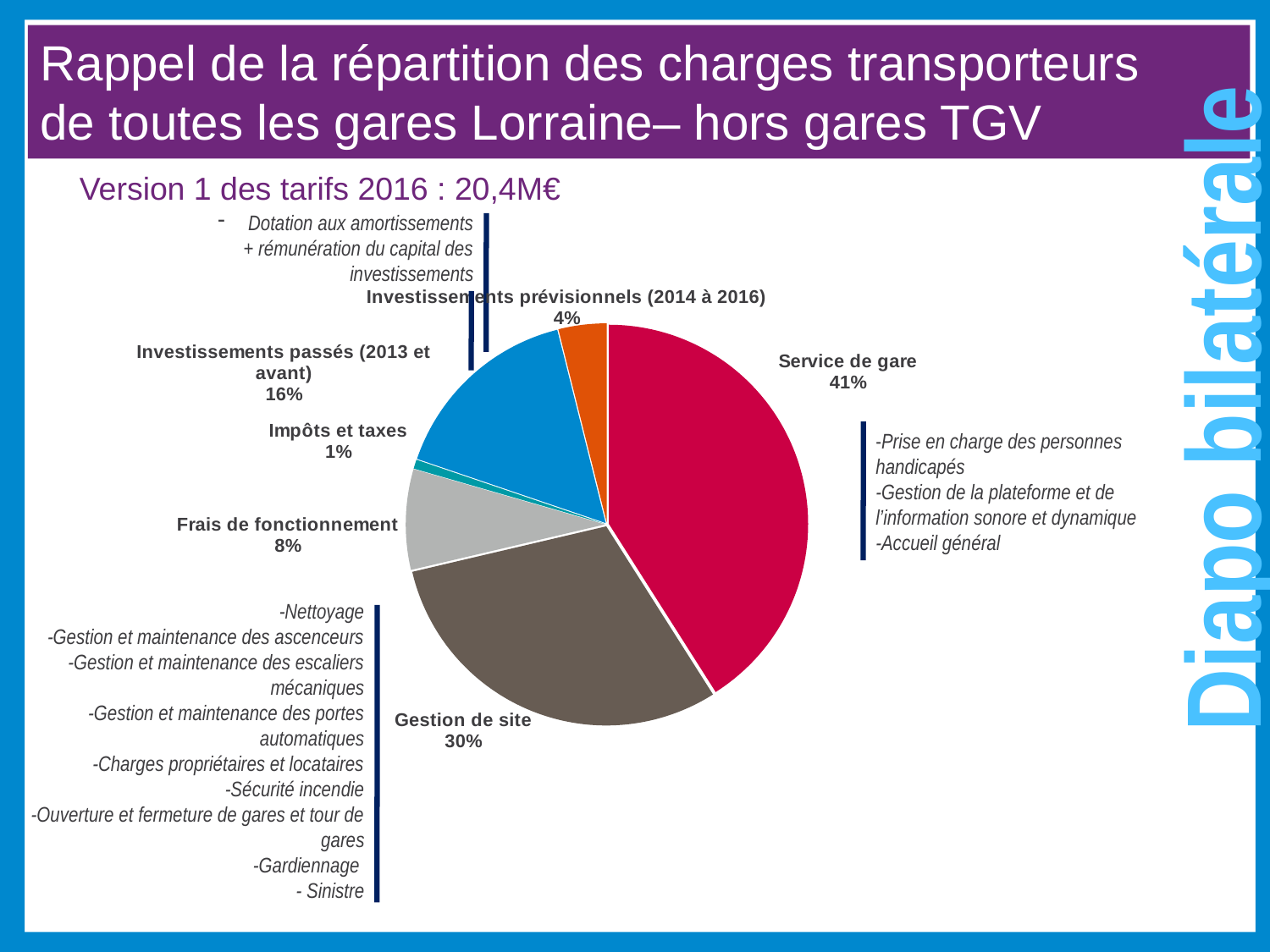
What total amount is stated for Version 1 des tarifs 2016 above the chart? 20,4M€ What share of the pie does "Service de gare" represent? 41% What percentage is shown for "Investissements prévisionnels (2014 à 2016)"? 4% What is the difference in percentage points between "Service de gare" and "Gestion de site"? 11 How many slices does the pie chart have? 6 What percentage is shown for "Investissements passés (2013 et avant)"? 16% Which category has the largest share of the pie? Service de gare What percentage is shown for "Frais de fonctionnement"? 8% What share of the pie does "Gestion de site" represent? 30% Which category has the smallest share of the pie? Impôts et taxes What kind of chart is shown on the slide? Pie chart Which is larger, "Frais de fonctionnement" or "Investissements passés (2013 et avant)"? Investissements passés (2013 et avant)